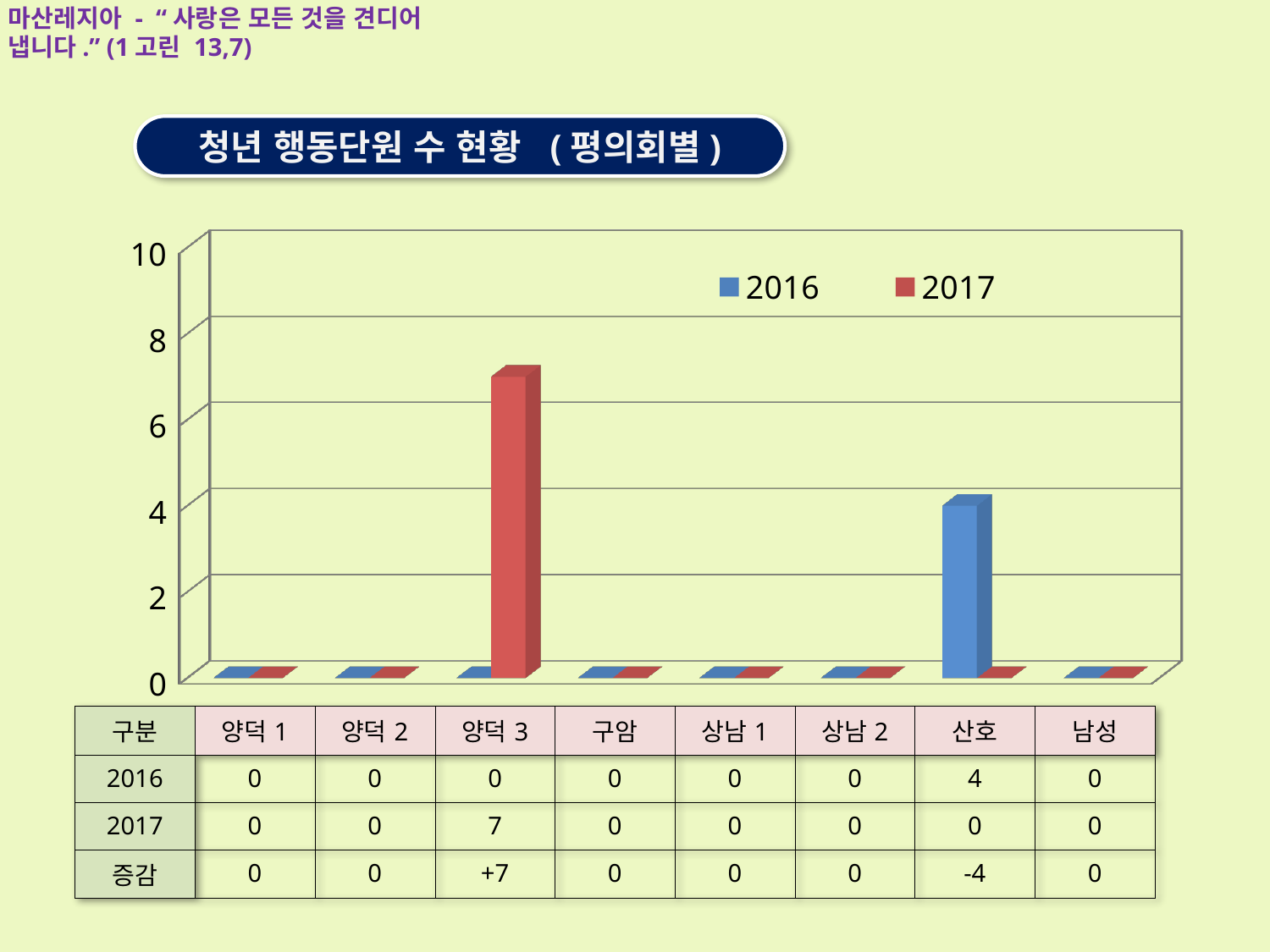
Which series is shown in red in the chart legend? 2017 Which category has the highest 2017 value? 양덕 3 Which category has the highest 2016 value? 산호 What is the 2017 value for 산호? 0 Which is larger: the 2017 value for 양덕 3 or the 2016 value for 산호? 2017 value for 양덕 3 What kind of chart is shown on the slide? bar chart How many categories are shown along the x axis of the chart? 8 What is the 2017 value for 양덕 3? 7 What is the difference between the 2017 value for 양덕 3 and the 2016 value for 산호? 3 How many series does the chart legend list? 2 Is the 2017 value for 양덕 3 greater or less than 6? greater What is the 2016 value for 산호? 4